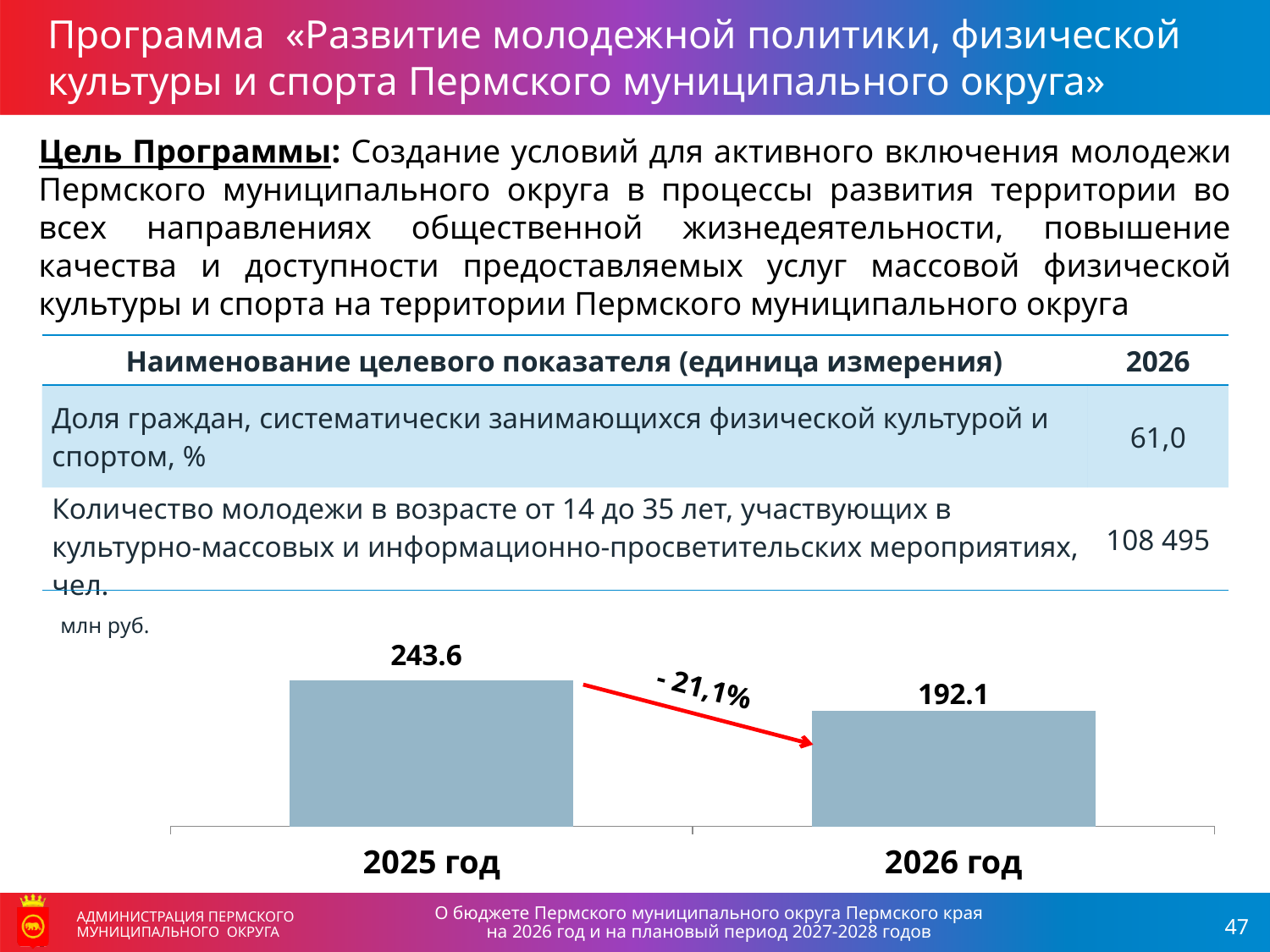
What is the value for 2025 год in the bar chart? 243.6 What is the difference between the 2025 год and 2026 год values in the bar chart? 51.5 Which year has the lower value in the bar chart? 2026 год What unit of measurement is indicated above the chart? млн руб. Is the value for 2025 год larger or smaller than the value for 2026 год? larger What kind of chart is shown on the slide? bar chart Which year has the higher value in the bar chart? 2025 год How many bars are shown in the chart? 2 Do the values rise or fall from 2025 год to 2026 год? fall What is the value for 2026 год in the bar chart? 192.1 What percentage change is written on the arrow between the two bars? - 21,1%